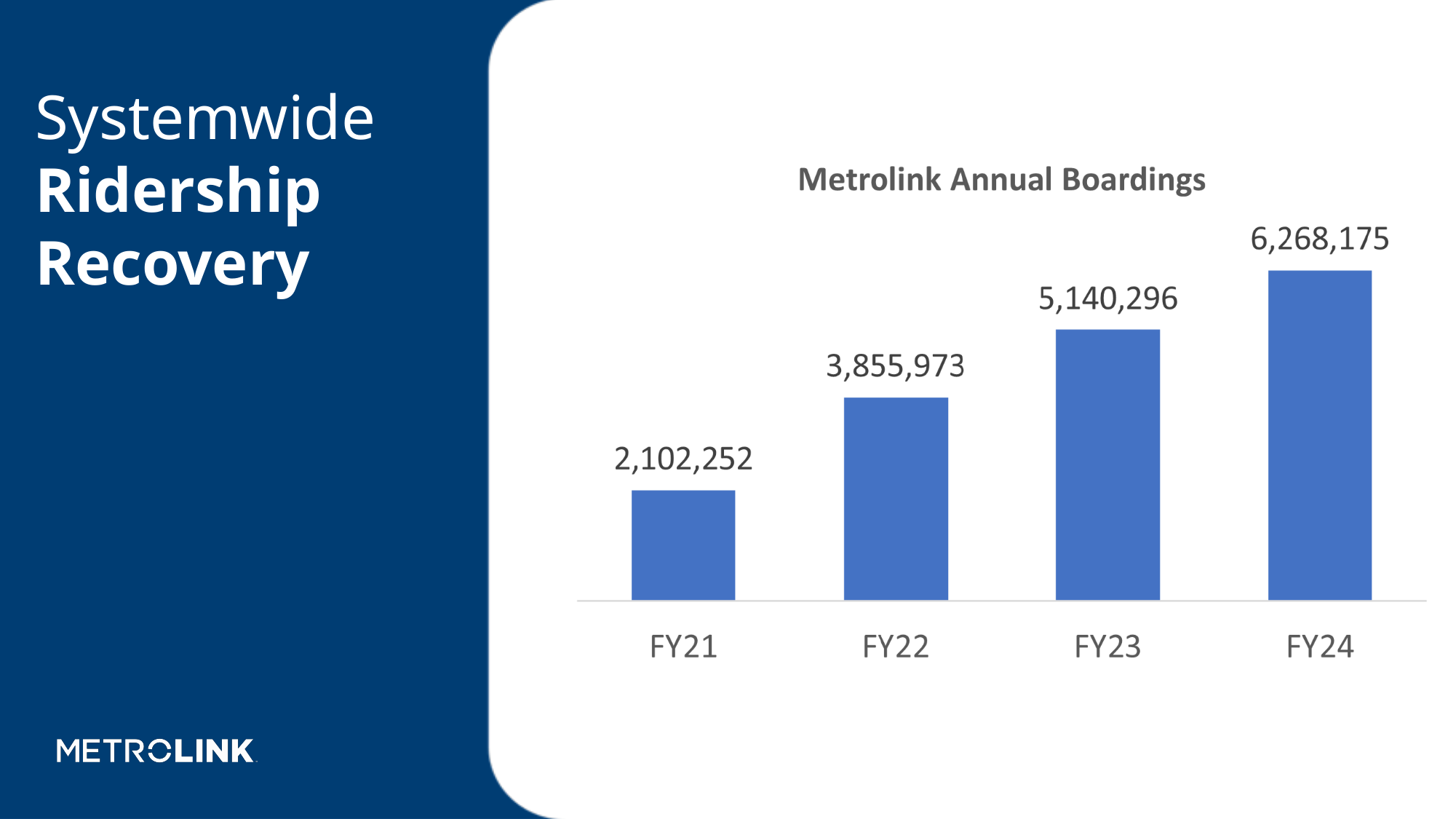
How many fiscal years are shown in the chart? 4 What is the value for FY23 in the Metrolink Annual Boardings chart? 5,140,296 What is the difference in annual boardings between FY24 and FY23? 1,127,879 Which fiscal year has the highest annual boardings? FY24 Do annual boardings rise or fall from FY21 to FY24? Rise What kind of chart is used to show Metrolink Annual Boardings? Bar chart Which has more annual boardings, FY22 or FY23? FY23 Which fiscal year has the lowest annual boardings? FY21 What is the difference in annual boardings between FY22 and FY21? 1,753,721 What is the value for FY22 in the Metrolink Annual Boardings chart? 3,855,973 What is the value for FY21 in the Metrolink Annual Boardings chart? 2,102,252 What is the value for FY24 in the Metrolink Annual Boardings chart? 6,268,175